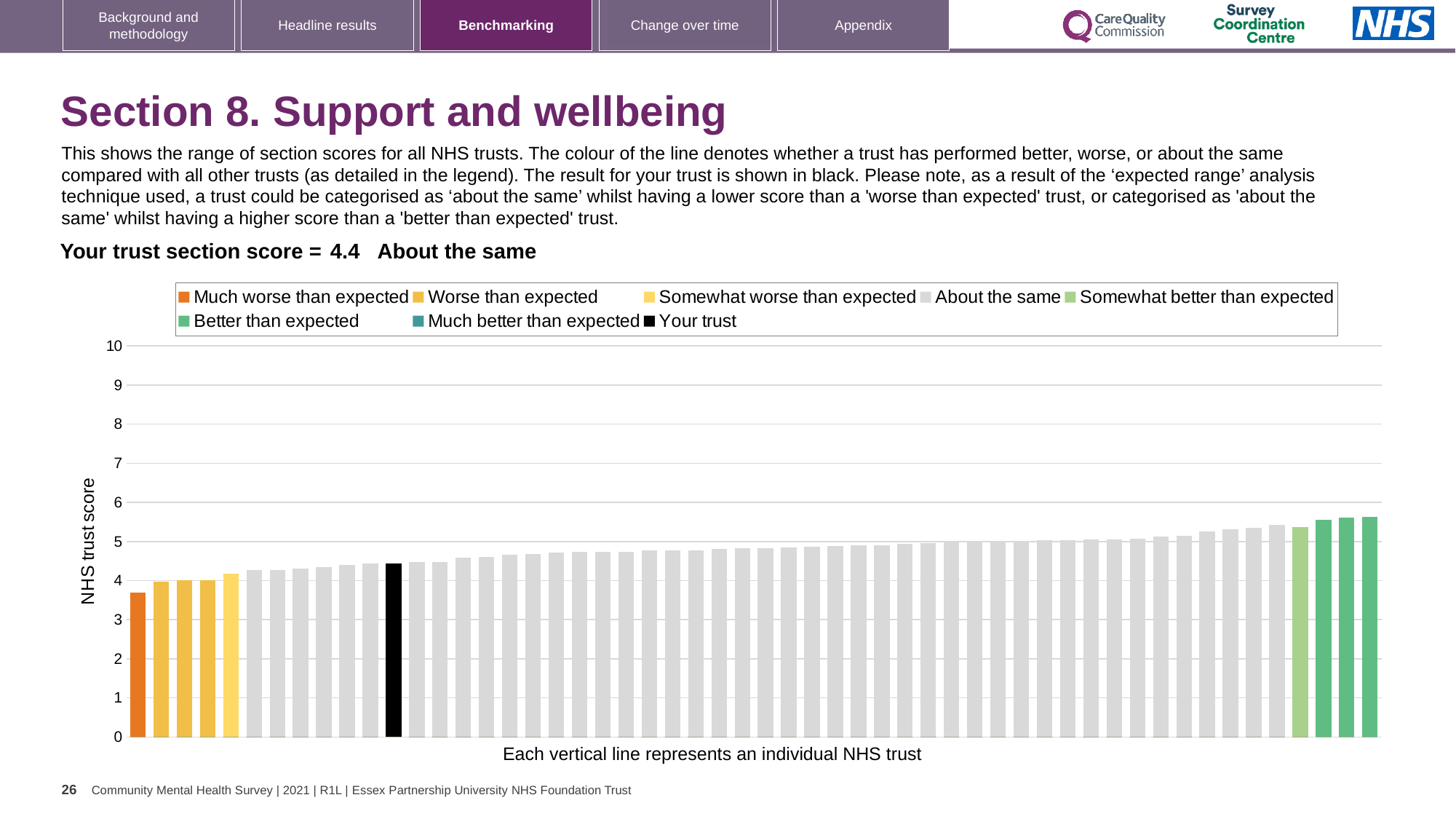
Which performance category is your trust placed in for this section? About the same How many bars are coloured as 'Much worse than expected'? 1 What is the label on the vertical axis of the chart? NHS trust score Which legend category does the lowest bar on the chart belong to? Much worse than expected Is the value for your trust (the black bar) greater or less than 5? less Which legend category does the highest bar on the chart belong to? Better than expected How many entries does the chart legend list? 8 Is the value of the tallest bar on the chart greater or less than 6? less Is the value of the lowest bar (the orange 'Much worse than expected' trust) greater or less than 4? less What is the section score for your trust shown on the slide? 4.4 What type of chart is shown on the slide? bar chart Do the bar values rise or fall from left to right along the x axis? rise